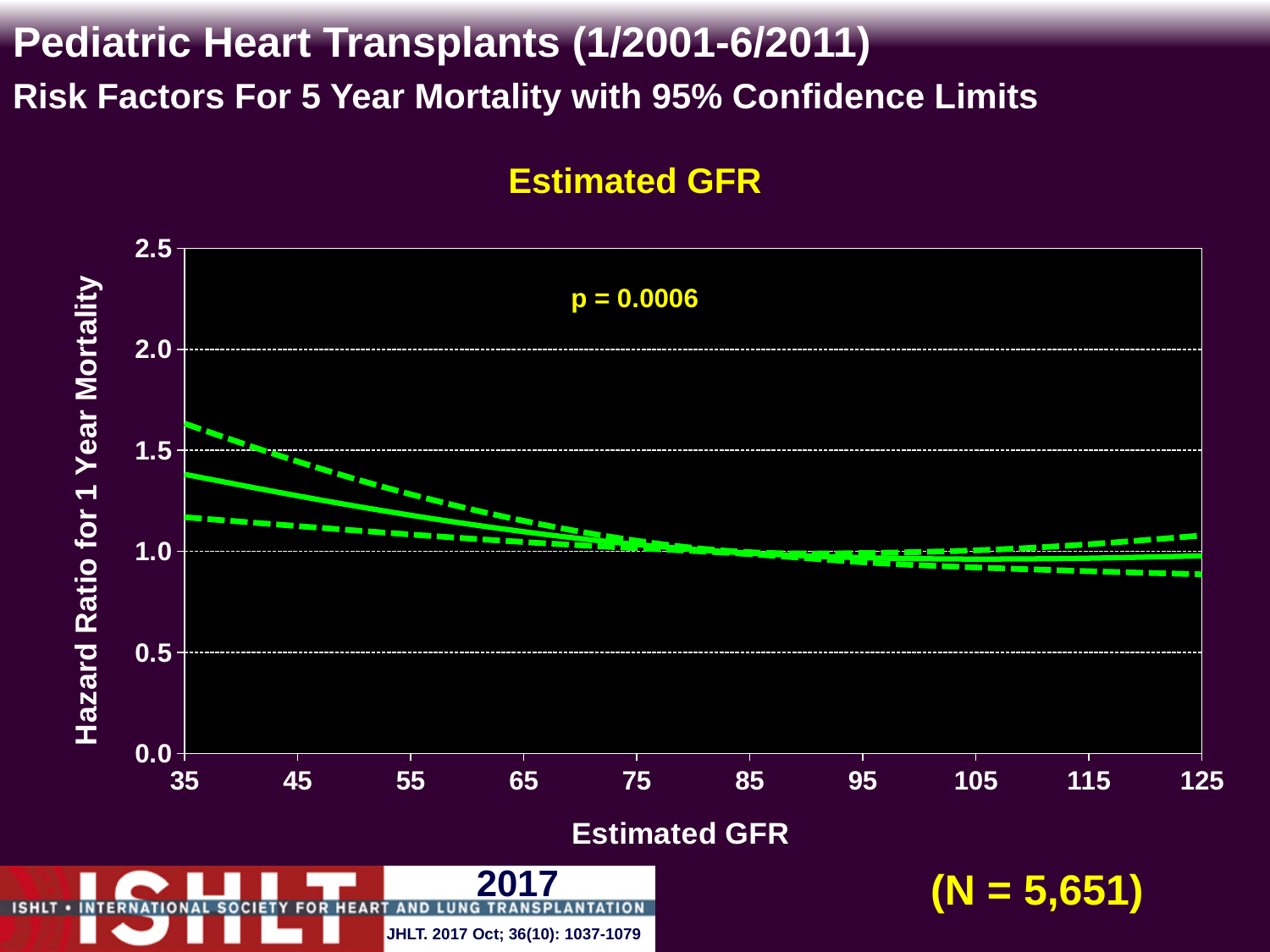
Is the hazard ratio (solid line) at an Estimated GFR of 35 greater or less than 1.5? less What sample size (N) is shown on the slide? N = 5,651 How many tick labels are shown on the x axis? 10 Is the hazard ratio (solid line) at an Estimated GFR of 35 greater or less than the hazard ratio at an Estimated GFR of 125? greater Is the lower confidence limit (lower dashed line) at an Estimated GFR of 125 greater or less than 1.0? less What p-value is printed on the chart? p = 0.0006 Does the solid hazard ratio line rise or fall as Estimated GFR increases from 35 to 85? fall What is the highest value shown on the y axis? 2.5 What is the label of the y axis? Hazard Ratio for 1 Year Mortality Is the hazard ratio (solid line) at an Estimated GFR of 35 greater or less than 1.0? greater What kind of chart is shown on the slide? line chart